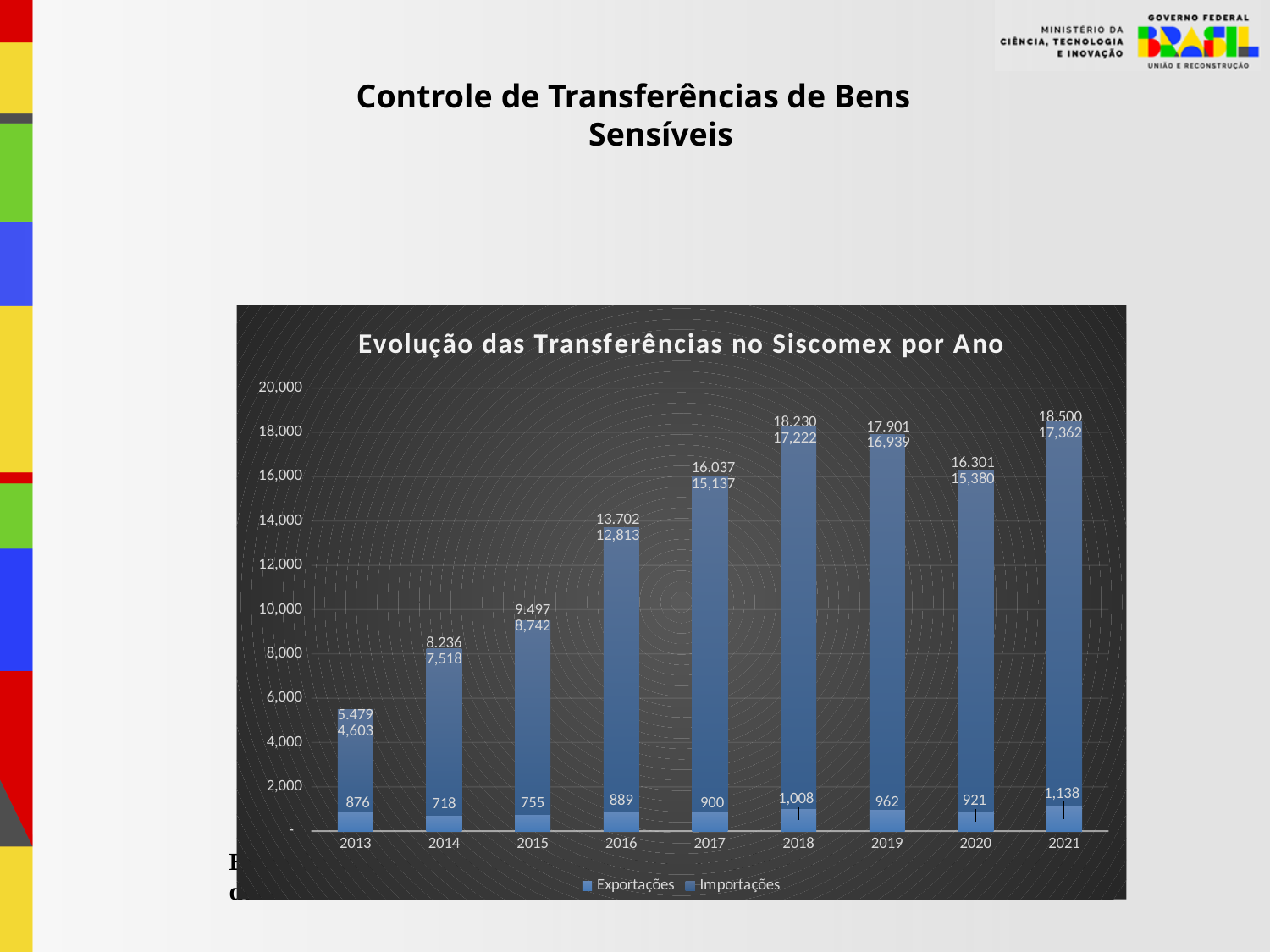
Which year has the highest Importações value? 2021 How many series does the legend list? 2 What is the value of Importações in 2016? 12,813 What is the difference between Importações in 2018 and Importações in 2019? 283 What is the value of Exportações in 2021? 1,138 What type of chart is shown on the slide? Stacked bar chart Which year has the lowest Exportações value? 2014 Which is larger, Importações in 2017 or Importações in 2020? Importações in 2020 What is the title of the chart? Evolução das Transferências no Siscomex por Ano How many years are shown on the x axis? 9 What is the total of the stacked bar for 2018? 18.230 Do the Importações values rise or fall from 2013 to 2018? Rise